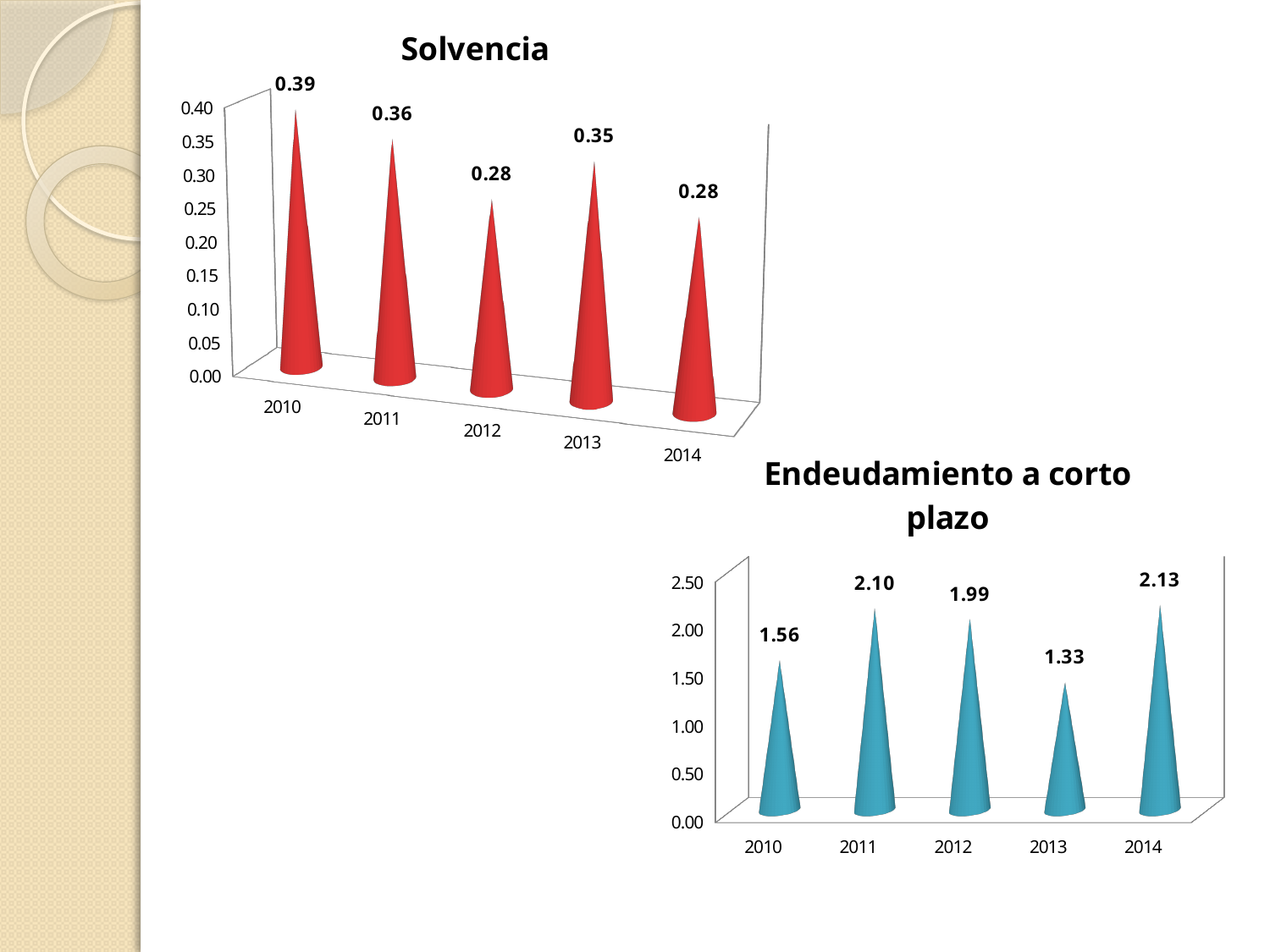
In the Solvencia chart, what is the difference between the values for 2010 and 2014? 0.11 In the Solvencia chart, is the value for 2011 greater or less than 0.30? greater In the Endeudamiento a corto plazo chart, which year has the highest value? 2014 In the Endeudamiento a corto plazo chart, which year has the lowest value? 2013 In the Solvencia chart, which year has the highest value? 2010 In the Endeudamiento a corto plazo chart, what is the value for 2013? 1.33 What colour are the bars in the Endeudamiento a corto plazo chart? Blue What kind of chart is the Solvencia chart? Bar chart In the Endeudamiento a corto plazo chart, what is the difference between the values for 2014 and 2010? 0.57 In the Solvencia chart, how many years are plotted? 5 In the Endeudamiento a corto plazo chart, which is larger, the value for 2011 or the value for 2012? 2011 In the Solvencia chart, what is the value for 2010? 0.39